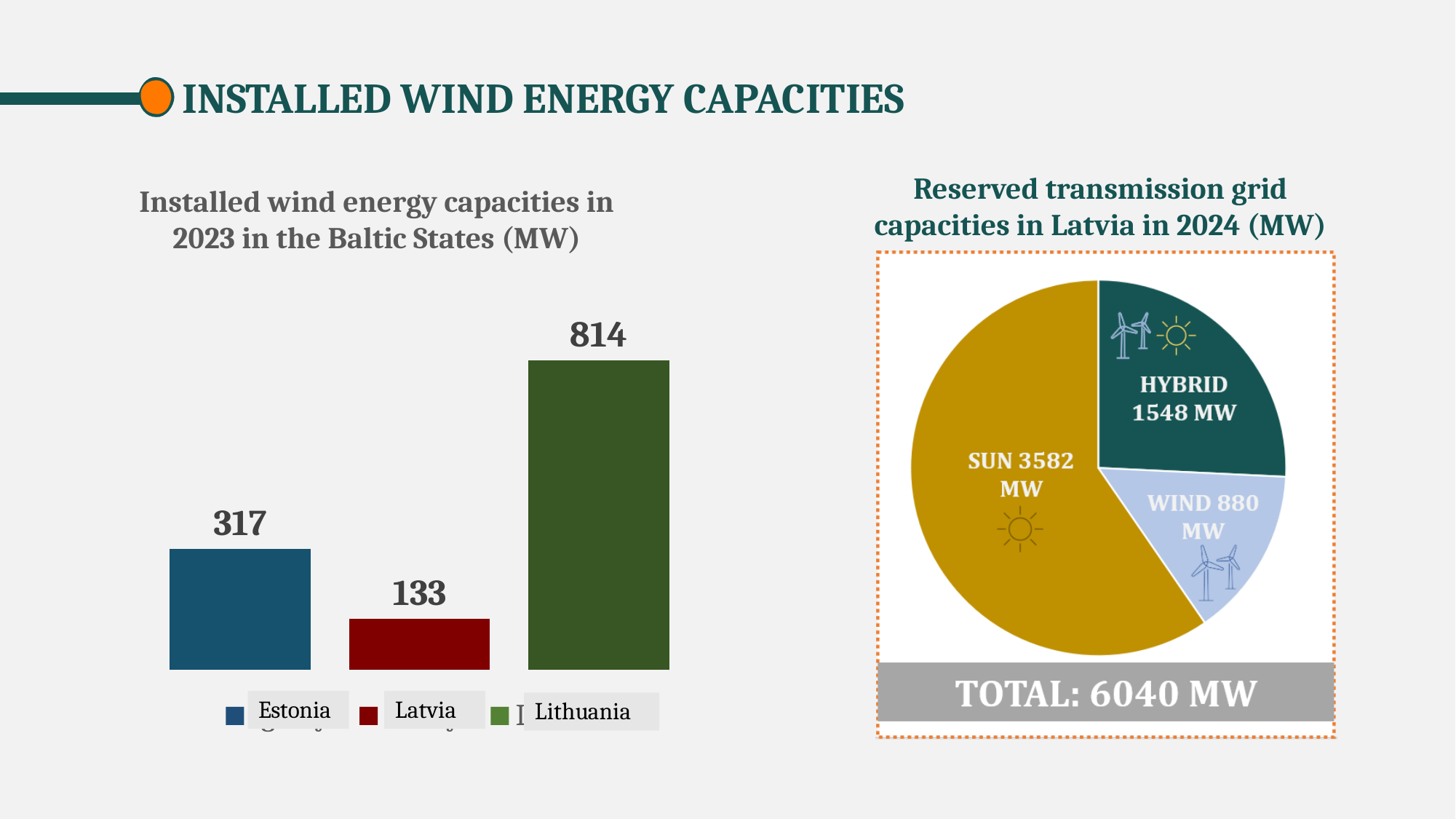
In the 'Reserved transmission grid capacities in Latvia in 2024 (MW)' chart, what is the total shown? 6040 MW In the 'Installed wind energy capacities in 2023 in the Baltic States (MW)' chart, which is larger, Estonia or Latvia? Estonia In the 'Installed wind energy capacities in 2023 in the Baltic States (MW)' chart, what is the value for Lithuania? 814 In the 'Installed wind energy capacities in 2023 in the Baltic States (MW)' chart, which country has the lowest installed capacity? Latvia In the 'Installed wind energy capacities in 2023 in the Baltic States (MW)' chart, what is the value for Latvia? 133 In the 'Installed wind energy capacities in 2023 in the Baltic States (MW)' chart, how many countries are shown? 3 What kind of chart is the 'Reserved transmission grid capacities in Latvia in 2024 (MW)' chart? pie chart In the 'Installed wind energy capacities in 2023 in the Baltic States (MW)' chart, which country has the highest installed capacity? Lithuania In the 'Reserved transmission grid capacities in Latvia in 2024 (MW)' chart, what is the value for HYBRID? 1548 MW In the 'Installed wind energy capacities in 2023 in the Baltic States (MW)' chart, what is the difference between Lithuania's and Estonia's values? 497 In the 'Reserved transmission grid capacities in Latvia in 2024 (MW)' chart, which category has the largest slice? SUN What kind of chart is the 'Installed wind energy capacities in 2023 in the Baltic States (MW)' chart? bar chart